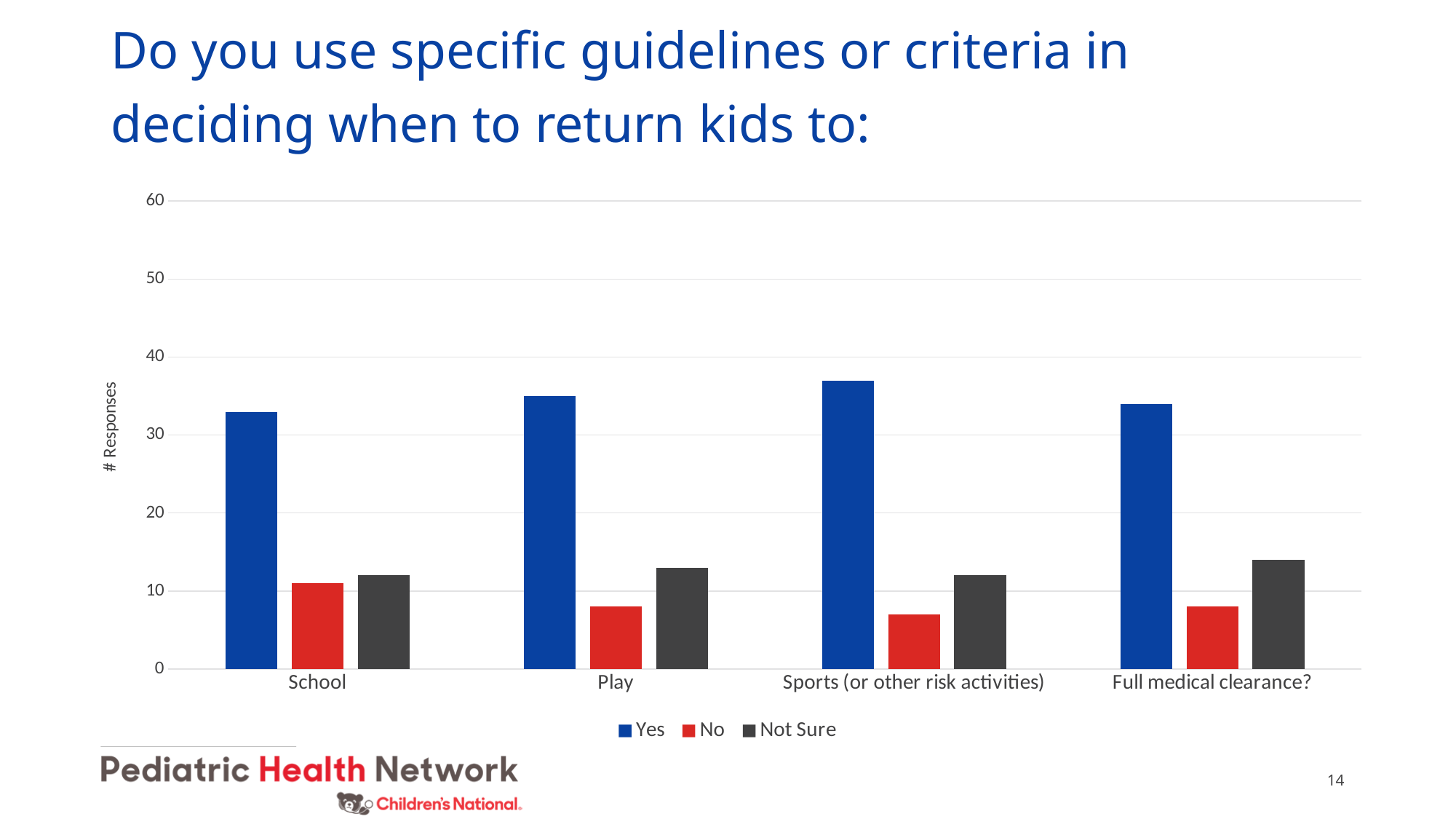
Which is larger: the Yes value for Sports (or other risk activities) or the Yes value for Full medical clearance? Sports (or other risk activities) For Play, which is larger: the No value or the Not Sure value? Not Sure How many categories are shown on the x axis? 4 Is the Yes value for Sports (or other risk activities) greater or less than 40? less What is the label on the vertical axis? # Responses Is the Yes value for School greater or less than 30? greater Which category has the highest Yes value? Sports (or other risk activities) Is the Not Sure value for Full medical clearance? greater or less than 10? greater Which category has the highest No value? School How many series does the legend list? 3 What kind of chart is shown on the slide? bar chart